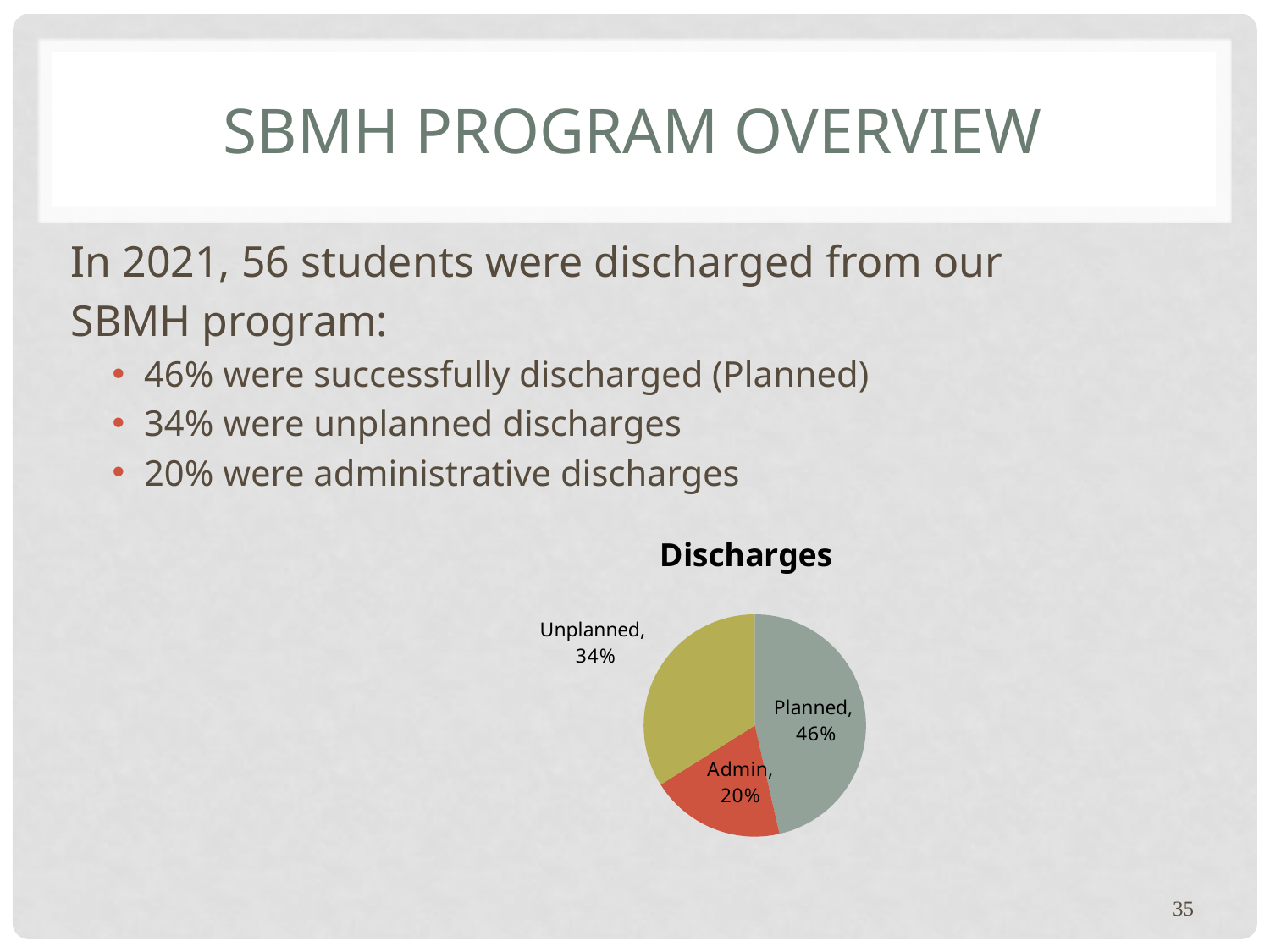
What is the difference in percentage points between the Unplanned and Admin slices? 14 What share of discharges is Planned? 46% What is the title of the chart? Discharges What kind of chart is shown on the slide? pie chart What share of discharges is Admin? 20% Which category has the largest slice of the pie? Planned Which is larger, the Unplanned slice or the Admin slice? Unplanned What colour is the Admin slice of the pie? red What share of discharges is Unplanned? 34% What is the difference in percentage points between the Planned and Unplanned slices? 12 How many slices does the pie chart have? 3 Which category has the smallest slice of the pie? Admin